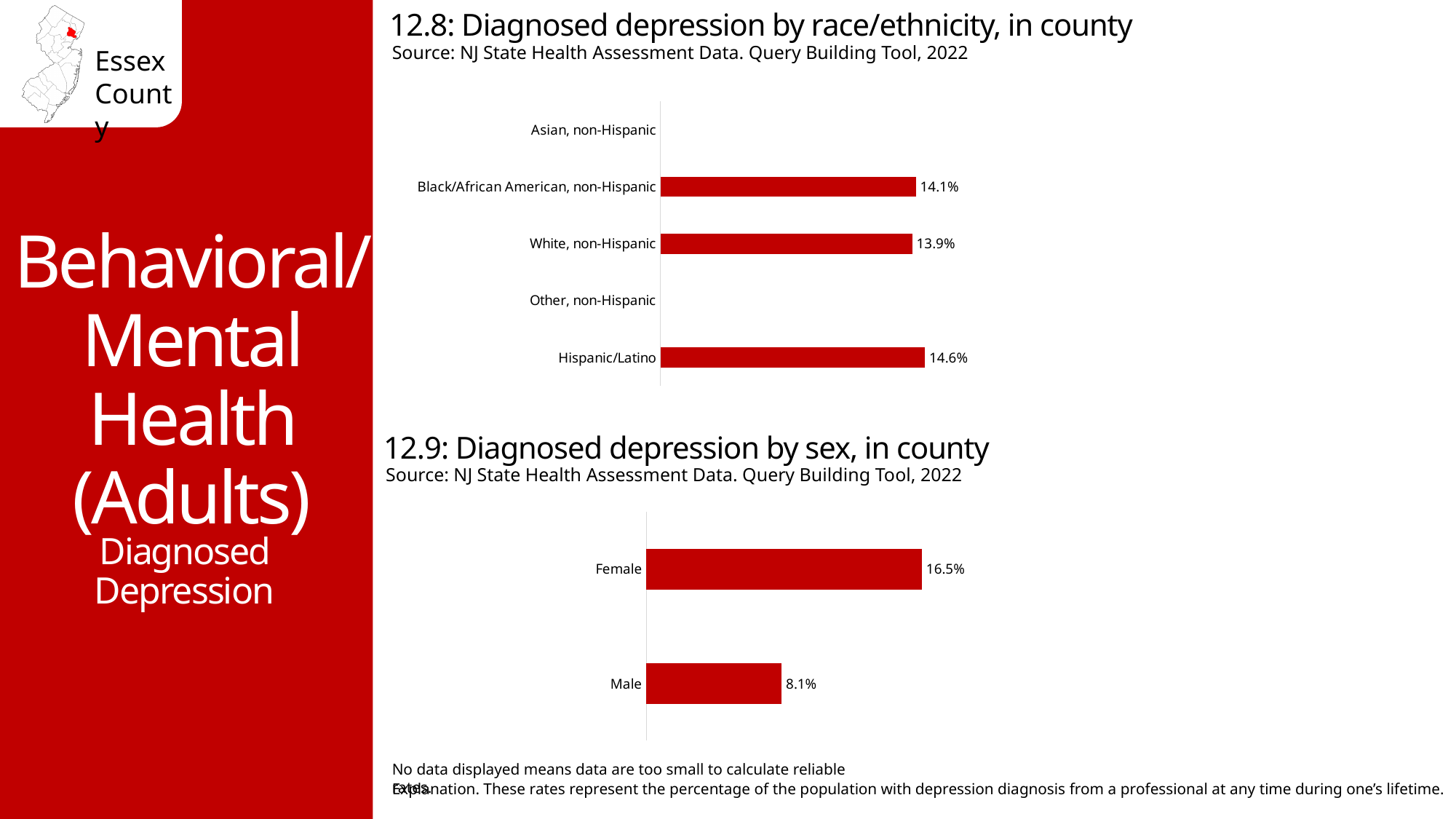
In the chart '12.8: Diagnosed depression by race/ethnicity, in county', what is the value for Black/African American, non-Hispanic? 14.1% In the chart '12.8: Diagnosed depression by race/ethnicity, in county', what is the value for Hispanic/Latino? 14.6% In the chart '12.8: Diagnosed depression by race/ethnicity, in county', what is the value for White, non-Hispanic? 13.9% In the chart '12.9: Diagnosed depression by sex, in county', what is the value for Male? 8.1% What type of chart is '12.9: Diagnosed depression by sex, in county'? Bar chart In the chart '12.8: Diagnosed depression by race/ethnicity, in county', what is the difference between the Hispanic/Latino and White, non-Hispanic values? 0.7% In the chart '12.8: Diagnosed depression by race/ethnicity, in county', how many categories are listed on the axis? 5 In the chart '12.8: Diagnosed depression by race/ethnicity, in county', which categories have no bar displayed? Asian, non-Hispanic and Other, non-Hispanic In the chart '12.9: Diagnosed depression by sex, in county', which category has the lower value? Male In the chart '12.9: Diagnosed depression by sex, in county', what is the difference between the Female and Male values? 8.4% In the chart '12.8: Diagnosed depression by race/ethnicity, in county', which category with a displayed value has the highest rate? Hispanic/Latino In the chart '12.9: Diagnosed depression by sex, in county', what is the value for Female? 16.5%